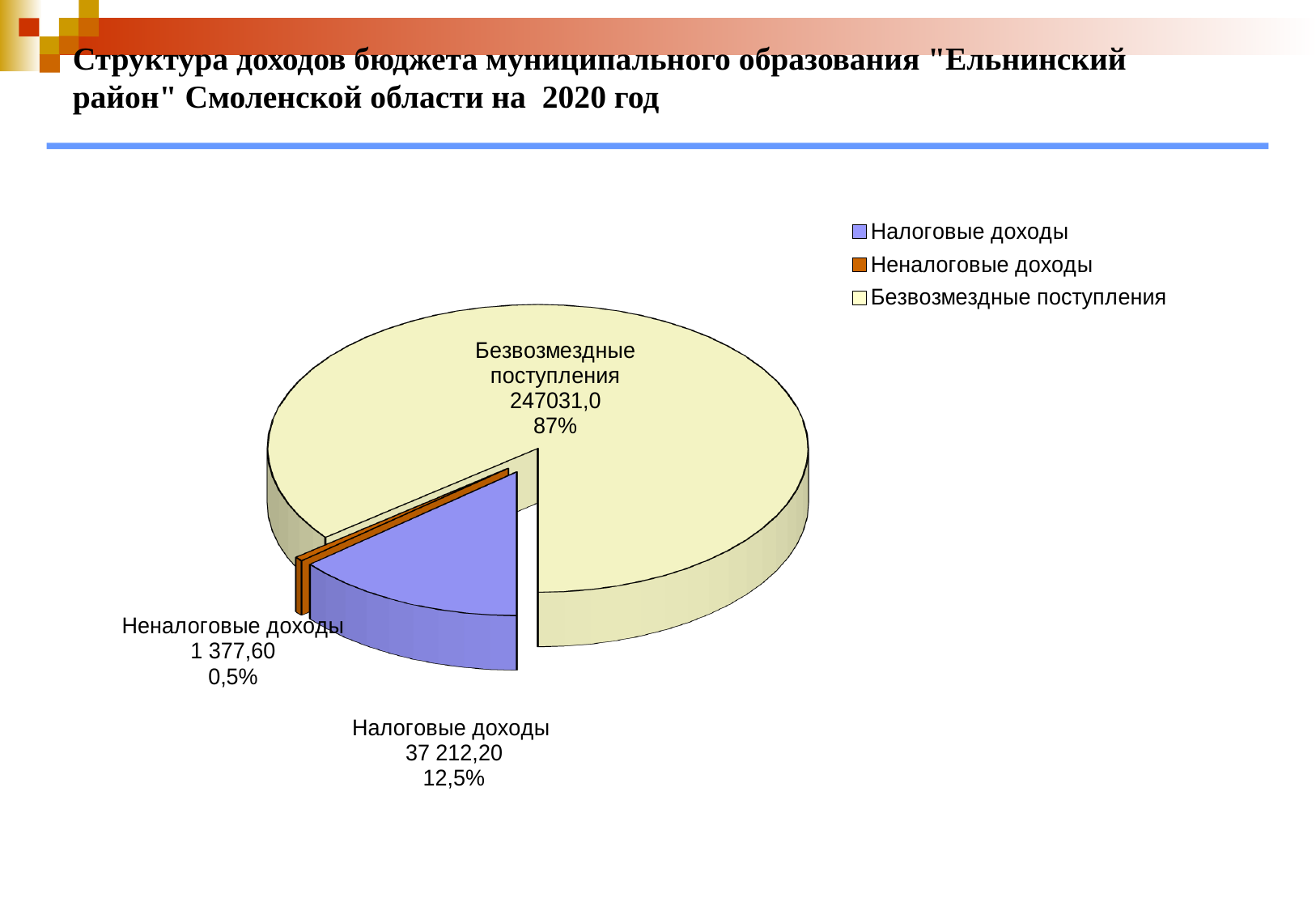
What kind of chart is shown on the slide? pie chart How many entries does the legend list? 3 Which is larger, Налоговые доходы or Неналоговые доходы? Налоговые доходы What share of the pie is Налоговые доходы? 12,5% What is the value shown for Неналоговые доходы? 1 377,60 What share of the pie is Неналоговые доходы? 0,5% What share of the pie is Безвозмездные поступления? 87% Which category has the smallest slice of the pie? Неналоговые доходы What is the value shown for Безвозмездные поступления? 247031,0 Which category has the largest slice of the pie? Безвозмездные поступления What is the value shown for Налоговые доходы? 37 212,20 How many slices does the pie chart have? 3